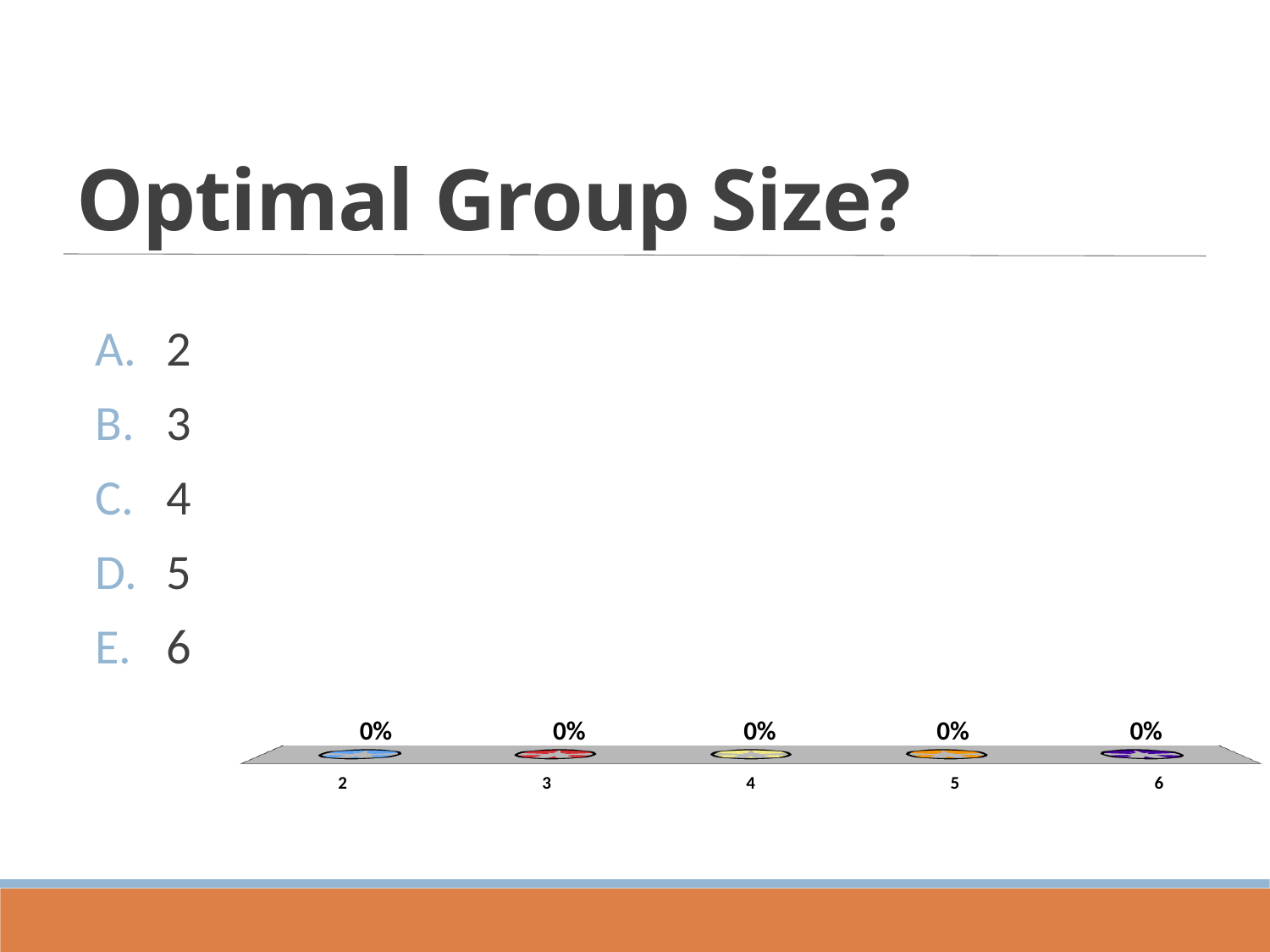
What is the difference between the values for category 2 and category 6? 0% What colour is the bar for category 2? blue Do the values rise, fall, or stay the same across the categories from 2 to 6? stay the same What is the value shown for category 6? 0% What is the difference between the values for category 3 and category 5? 0% What is the value shown for category 4? 0% What is the value shown for category 3? 0% What kind of chart is shown on the slide? bar chart How many categories are plotted on the chart? 5 What is the title of the slide containing the chart? Optimal Group Size? What is the value shown for category 5? 0% What is the value shown for category 2? 0%